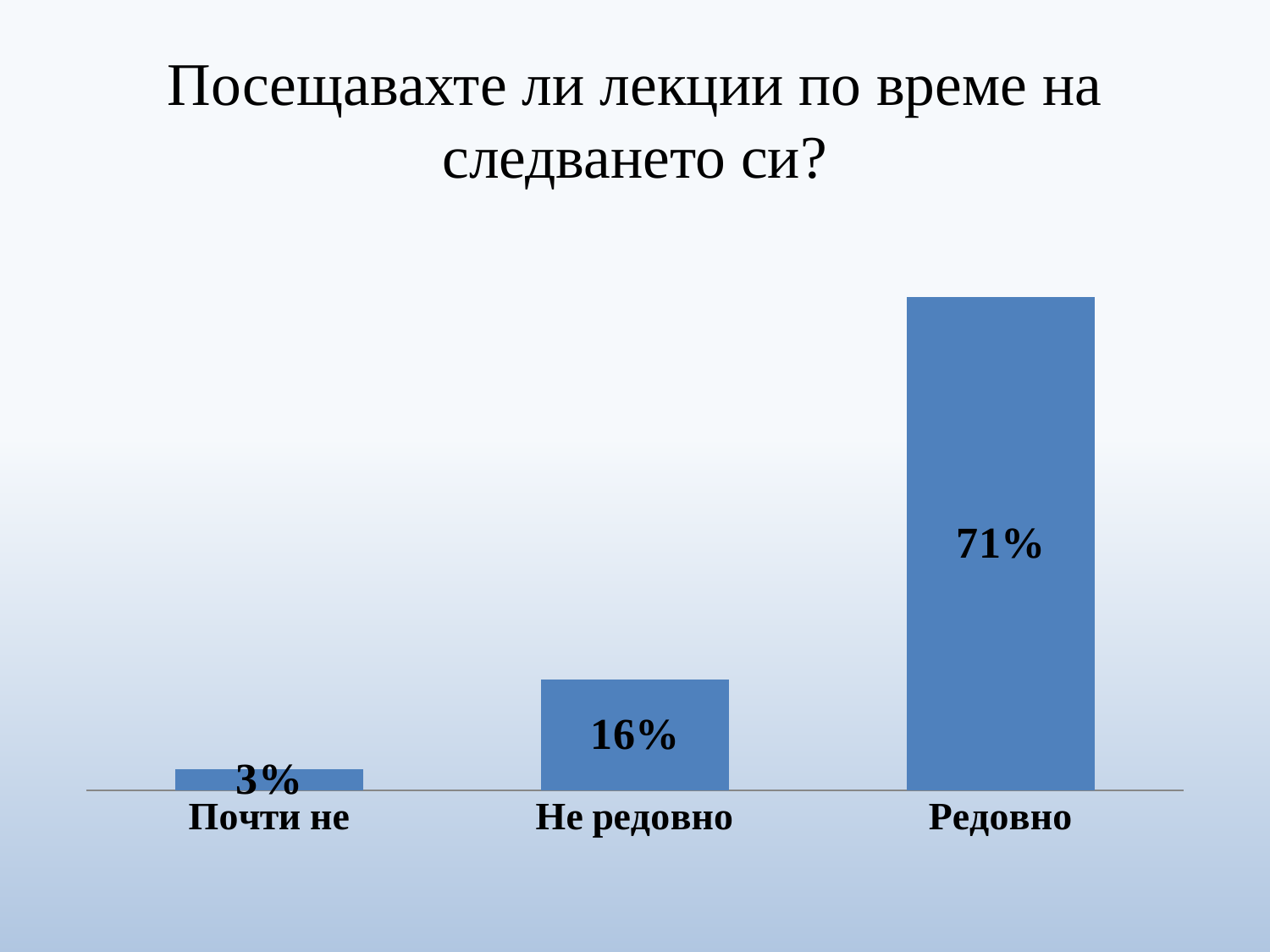
What is the difference between the values for "Не редовно" and "Почти не"? 13% What kind of chart is shown on the slide? Bar chart Which category has the highest value? Редовно What is the value for "Почти не"? 3% What is the title of the slide? Посещавахте ли лекции по време на следването си? Which category has the lowest value? Почти не What is the value for "Не редовно"? 16% What is the value for "Редовно"? 71% What is the difference between the values for "Редовно" and "Не редовно"? 55% Do the values rise or fall from left to right along the x axis? Rise How many categories are shown on the chart? 3 Which is larger, the value for "Не редовно" or the value for "Почти не"? Не редовно